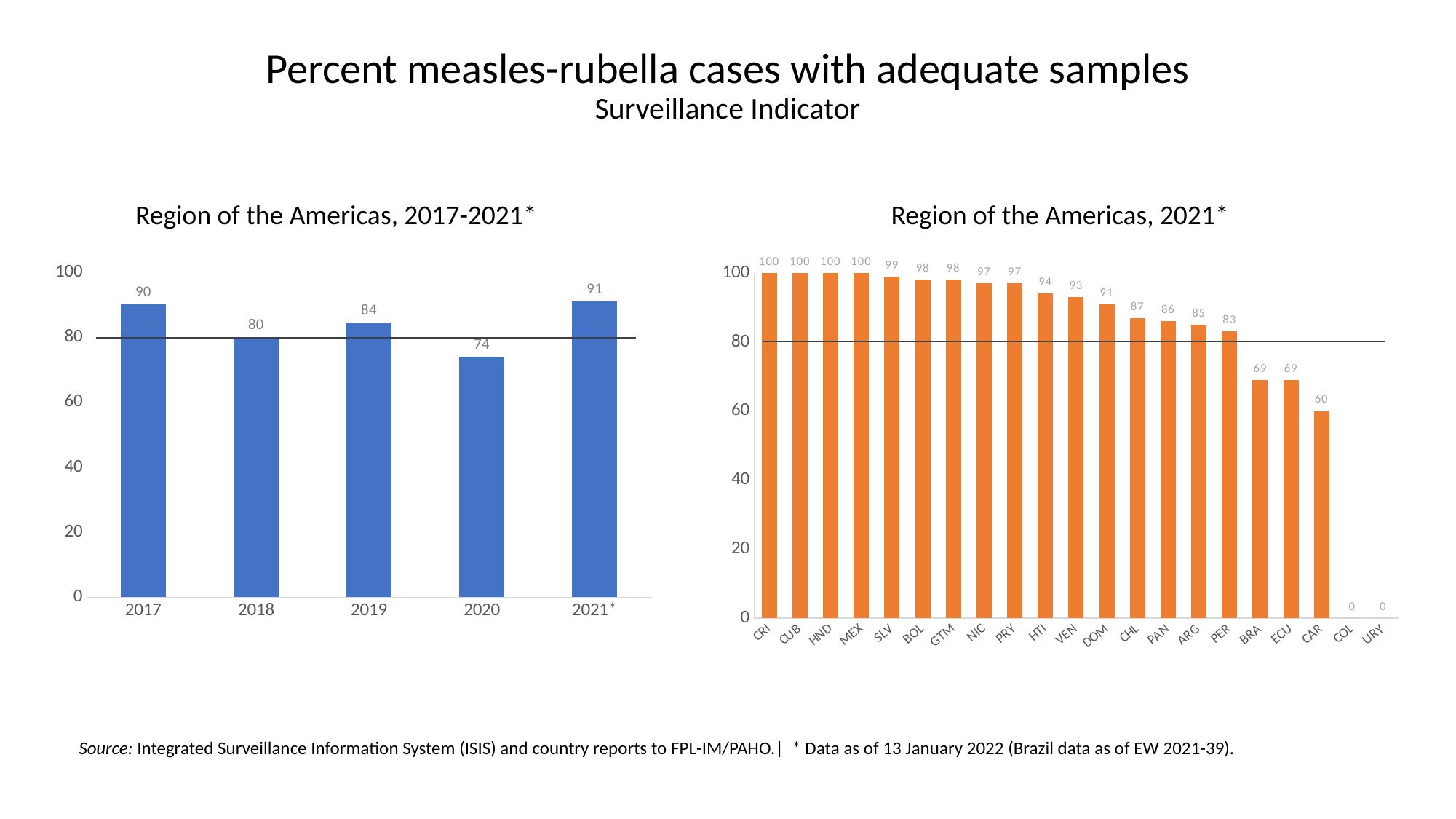
In the 'Region of the Americas, 2021*' chart, which of BRA or PER has the larger value? PER In the 'Region of the Americas, 2021*' chart, what is the difference between the values for CHL and CAR? 27 In the 'Region of the Americas, 2017-2021*' chart, how many years are shown on the x axis? 5 In the 'Region of the Americas, 2021*' chart, how many countries are listed on the x axis? 21 In the 'Region of the Americas, 2017-2021*' chart, which year has the lowest value? 2020 In the 'Region of the Americas, 2017-2021*' chart, is the value for 2019 greater or less than 80? greater In the 'Region of the Americas, 2021*' chart, what is the value for DOM? 91 In the 'Region of the Americas, 2017-2021*' chart, what is the value for 2020? 74 In the 'Region of the Americas, 2021*' chart, what is the value for CAR? 60 In the 'Region of the Americas, 2017-2021*' chart, which year has the highest value? 2021* In the 'Region of the Americas, 2017-2021*' chart, what is the difference between the values for 2017 and 2018? 10 What type of chart is the 'Region of the Americas, 2021*' chart? Bar chart